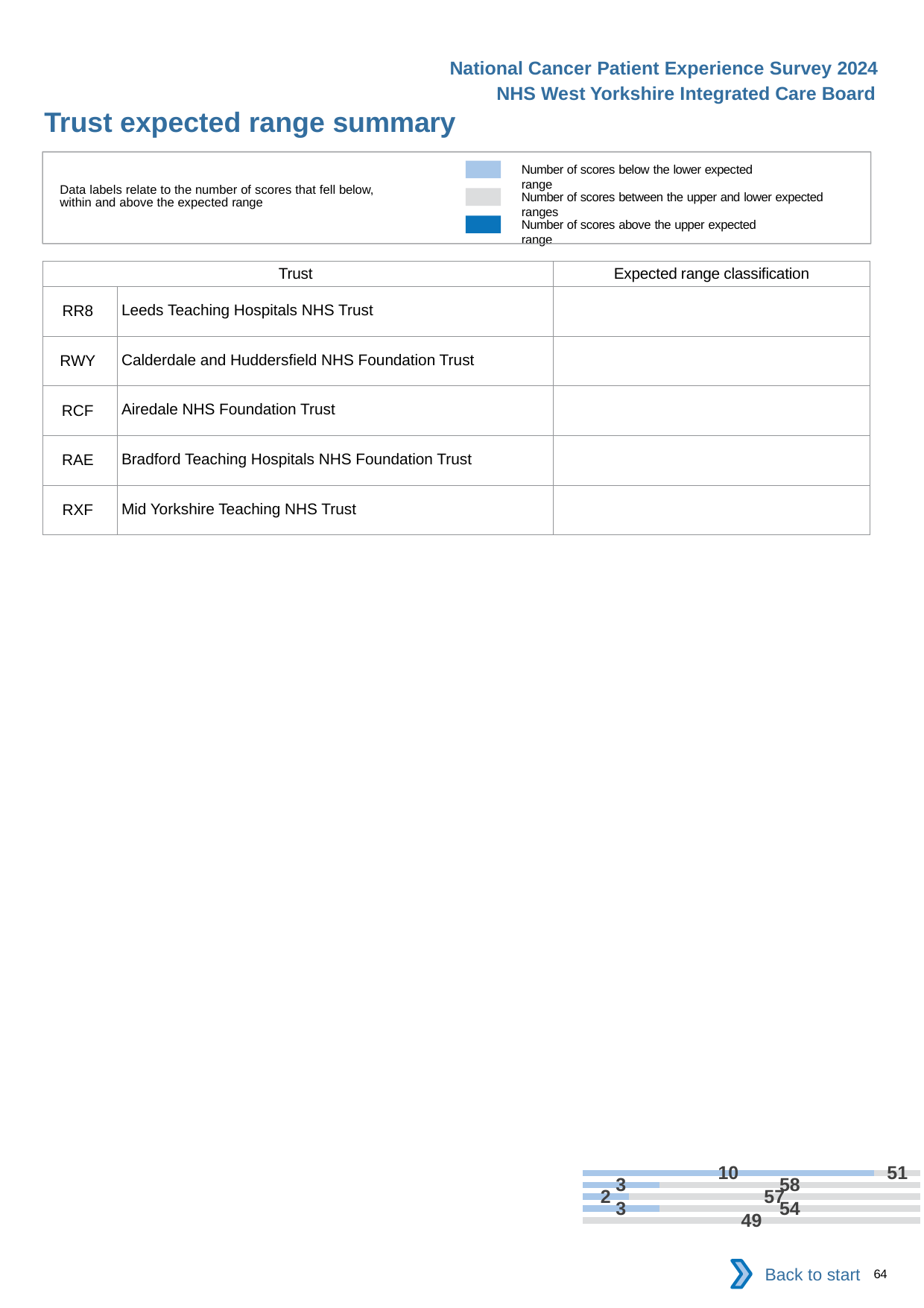
According to the legend, which colour represents the number of scores above the upper expected range? Dark blue In the chart at the bottom right, what is the grey (within expected range) value labelled on the second bar from the top? 58 In the chart at the bottom right, which bar has the largest light blue (below the lower expected range) value? The top bar How many entries does the legend at the top of the slide list for the chart? 3 How many bars are plotted in the chart at the bottom right of the slide? 5 In the chart at the bottom right, what is the grey (within expected range) value labelled on the top bar? 51 What kind of chart is shown at the bottom right of the slide? Bar chart In the chart at the bottom right, what is the total of the two labelled segments on the top bar? 61 In the chart at the bottom right, what is the grey (within expected range) value labelled on the bottom bar? 49 In the chart at the bottom right, what is the grey (within expected range) value labelled on the fourth bar from the top? 54 In the chart at the bottom right, what is the light blue (below the lower expected range) value labelled on the top bar? 10 In the chart at the bottom right, what is the light blue (below the lower expected range) value labelled on the third bar from the top? 2